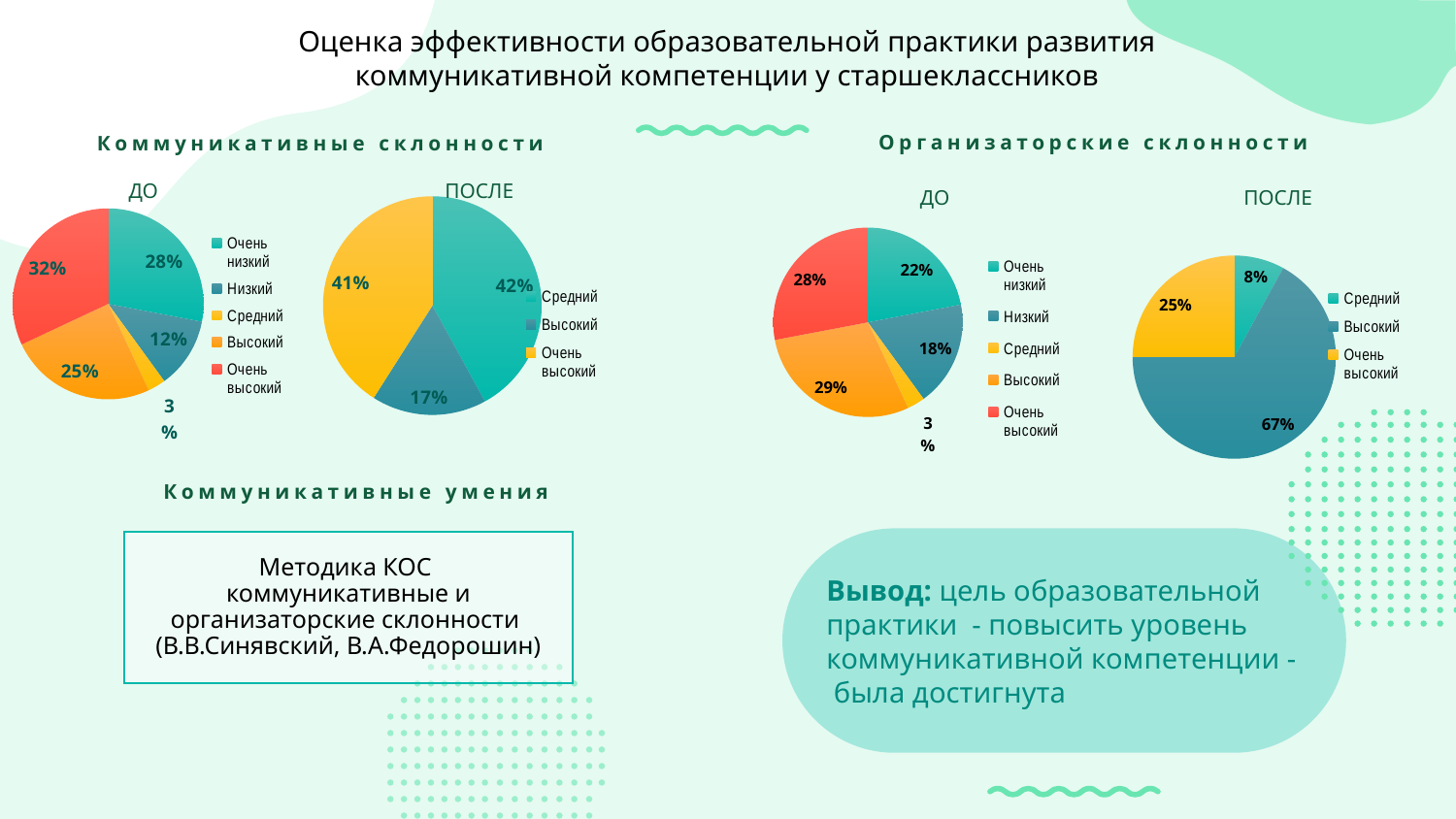
In the 'Коммуникативные склонности' ПОСЛЕ pie chart, which category has the largest share? Средний In the 'Коммуникативные склонности' ПОСЛЕ pie chart, what share is labelled 'Высокий'? 17% In the 'Организаторские склонности' ПОСЛЕ pie chart, what is the difference between the 'Высокий' and 'Очень высокий' shares? 42% In the 'Коммуникативные склонности' ДО pie chart, what share is labelled 'Низкий'? 12% In the 'Коммуникативные склонности' ДО pie chart, what share is labelled 'Очень высокий'? 32% In the 'Организаторские склонности' ДО pie chart, what share is labelled 'Очень низкий'? 22% How many categories does the legend of the 'Организаторские склонности' ДО pie chart list? 5 In the 'Коммуникативные склонности' ДО pie chart, which is larger: 'Очень низкий' or 'Высокий'? Очень низкий How many categories does the legend of the 'Коммуникативные склонности' ПОСЛЕ pie chart list? 3 What type of chart is used for the 'Организаторские склонности' ПОСЛЕ data? Pie chart In the 'Организаторские склонности' ПОСЛЕ pie chart, what share is labelled 'Высокий'? 67% In the 'Организаторские склонности' ДО pie chart, which category has the smallest share? Средний